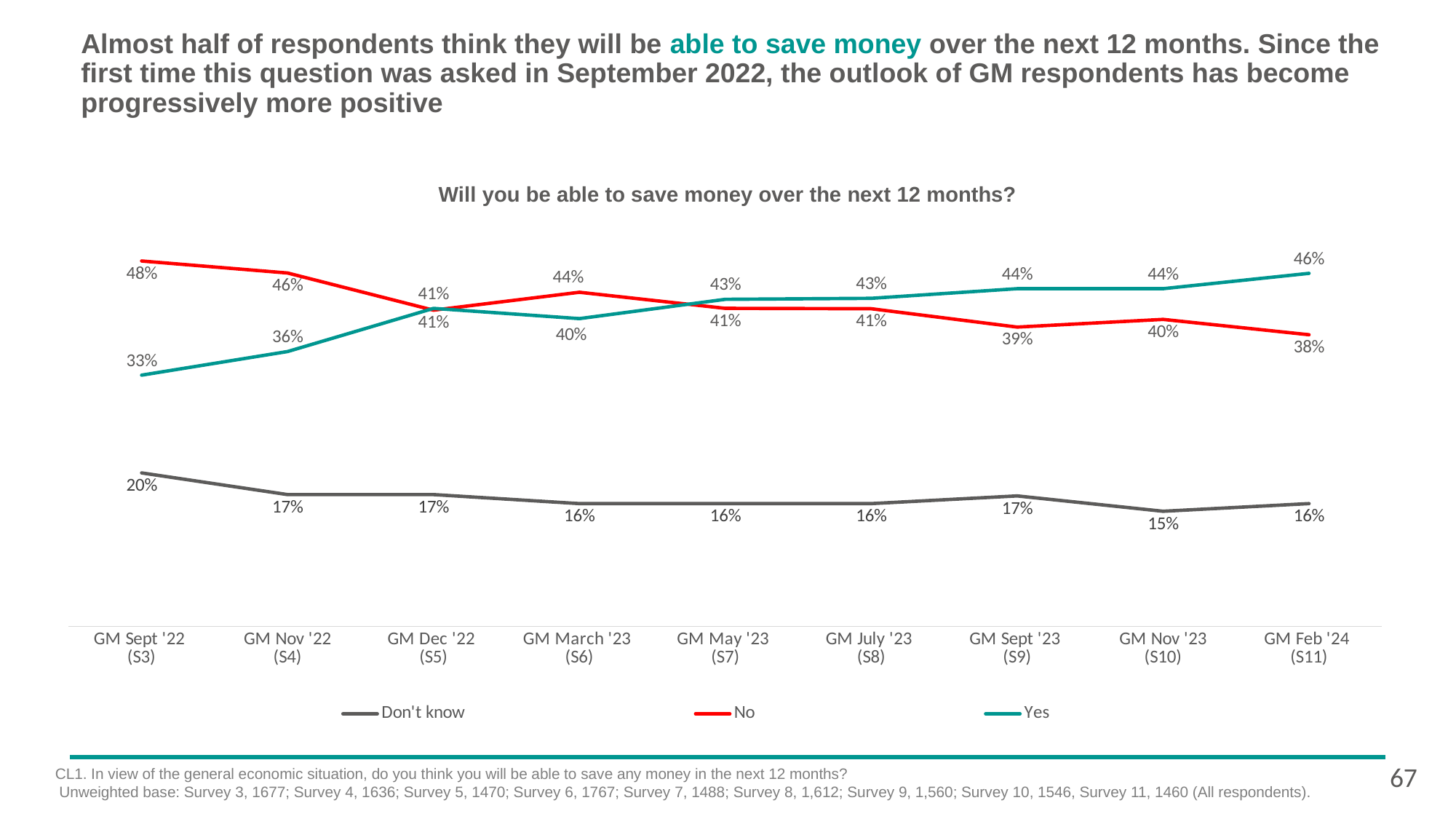
At which survey point is the Yes series at its lowest? GM Sept '22 (S3) What is the value for No at GM Sept '22 (S3)? 48% Does the Yes series generally rise or fall from GM Sept '22 to GM Feb '24? Rise What is the difference between the Yes and No values at GM Feb '24 (S11)? 8 percentage points At GM March '23 (S6), which is larger, Yes or No? No What is the value for Don't know at GM Nov '23 (S10)? 15% What colour is the line for the No series? Red At which survey point is the No series at its highest? GM Sept '22 (S3) What kind of chart is shown on the slide? Line chart What is the value for Yes at GM Feb '24 (S11)? 46% How many survey points are shown on the x axis? 9 How many series does the legend list? 3